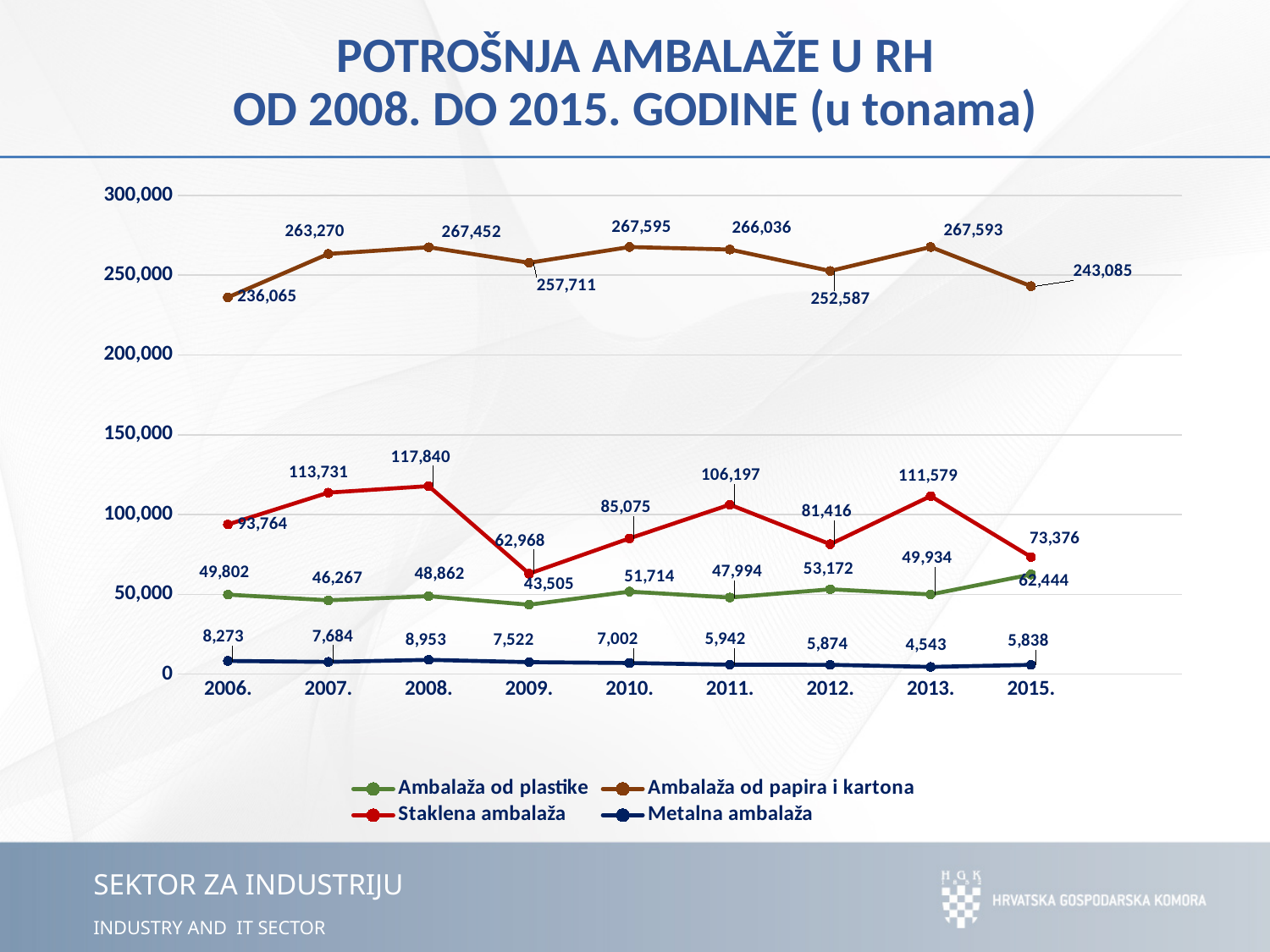
What is the difference between the Staklena ambalaža values for 2008. and 2009.? 54,872 What kind of chart is shown on the slide? Line chart What is the value for Metalna ambalaža in 2009.? 7,522 What is the value for Ambalaža od papira i kartona in 2010.? 267,595 Which is larger: Ambalaža od plastike in 2012. or Ambalaža od plastike in 2013.? 2012. What is the value for Ambalaža od plastike in 2015.? 62,444 In which year is Ambalaža od papira i kartona lowest? 2006. In which year is Metalna ambalaža lowest? 2013. What is the value for Staklena ambalaža in 2013.? 111,579 How many years are shown on the x axis? 9 How many series does the legend list? 4 In which year is Staklena ambalaža highest? 2008.